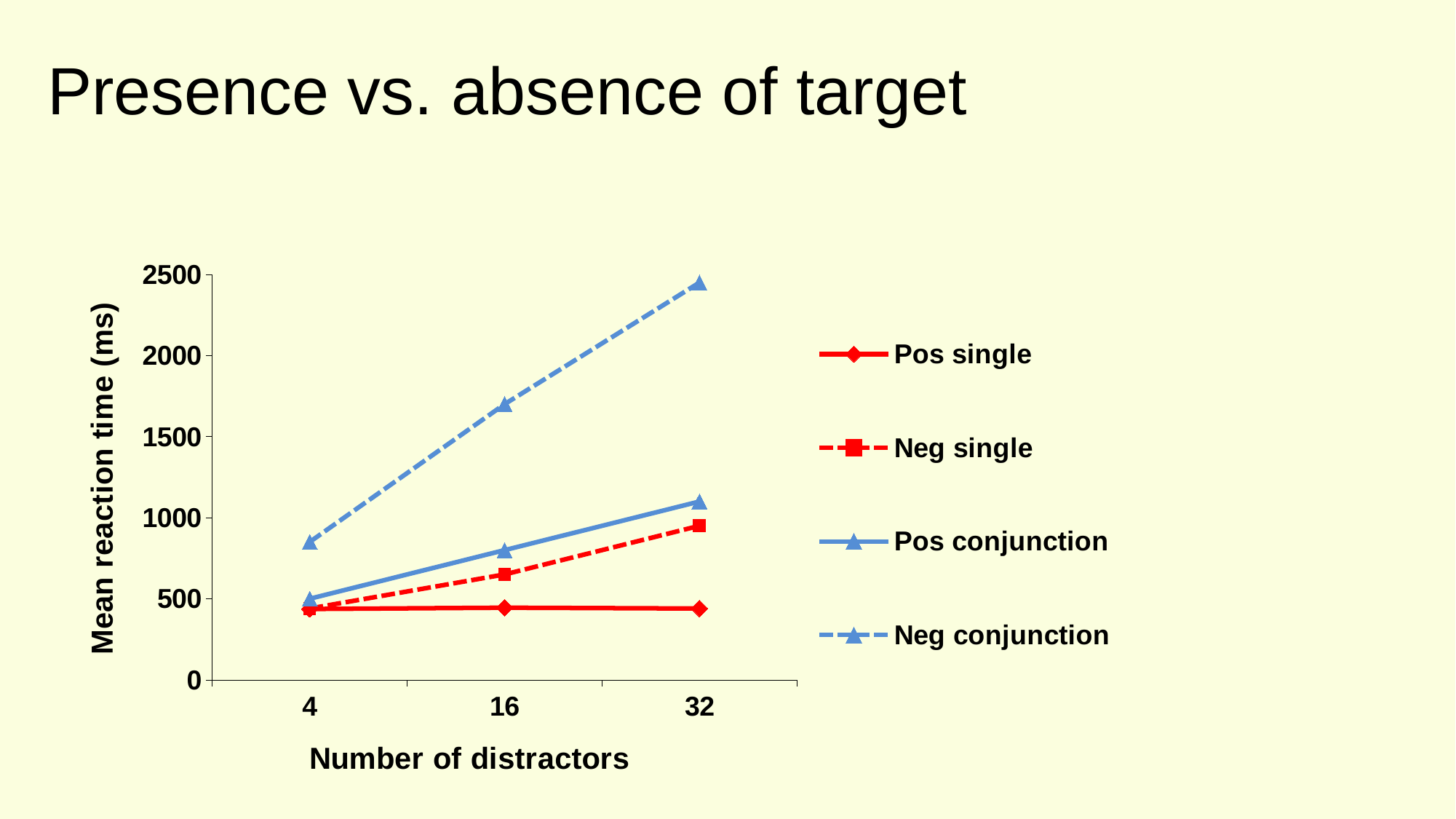
How many series does the legend list? 4 Does the Neg conjunction series rise or fall as the number of distractors increases? Rises At 16 distractors, which is larger: Pos conjunction or Neg single? Pos conjunction Which series has the highest mean reaction time at 32 distractors? Neg conjunction Is the value for Pos conjunction at 32 distractors greater or less than 1000? greater Is the value for Neg conjunction at 32 distractors greater or less than 2000? greater How many values of Number of distractors are plotted on the x axis? 3 What is the label of the y axis? Mean reaction time (ms) Is the value for Neg conjunction at 16 distractors greater or less than 1500? greater What kind of chart is shown on the slide? Line chart Which series has the lowest mean reaction time at 32 distractors? Pos single